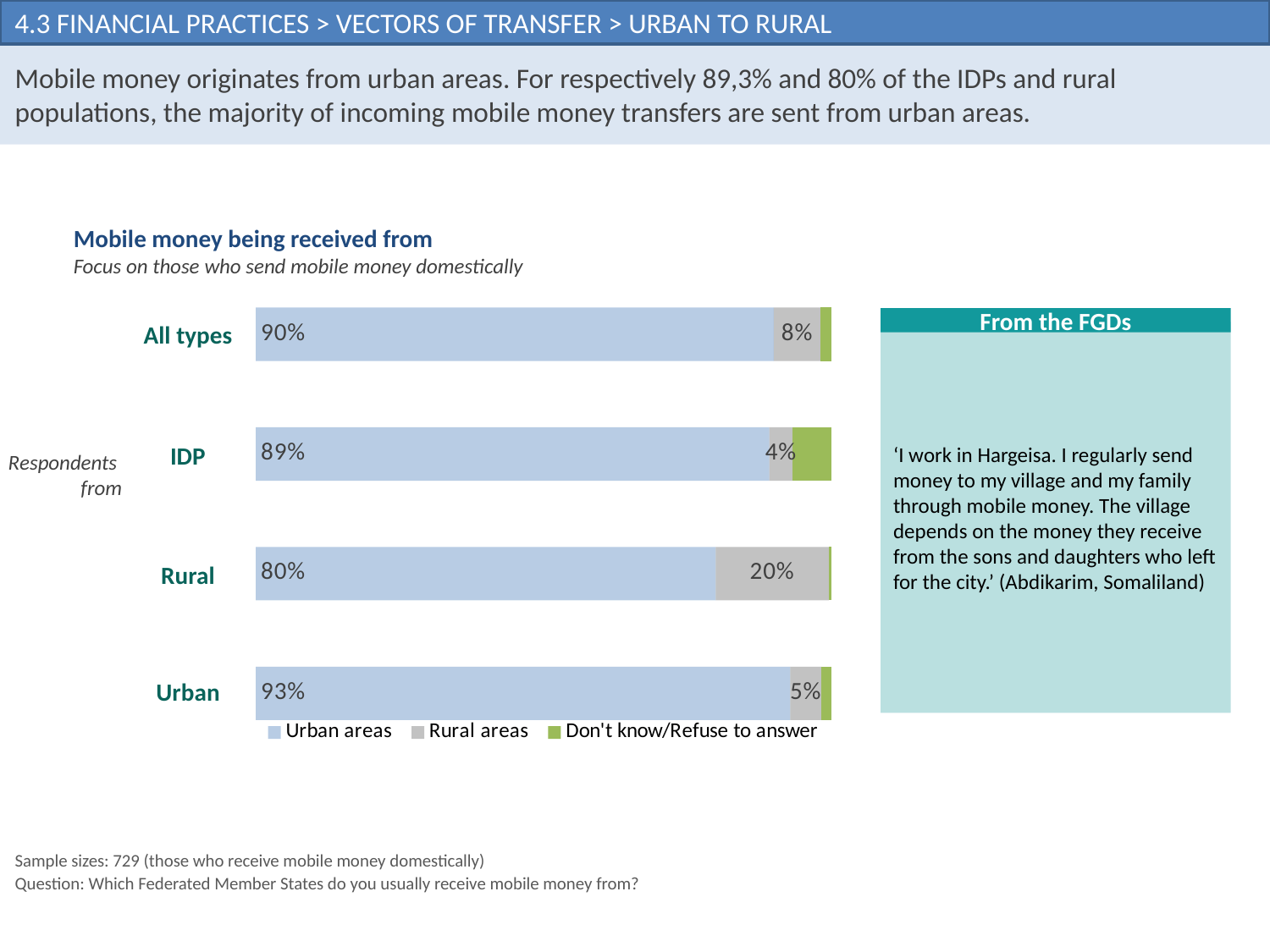
Which respondent group has the highest 'Urban areas' share? Urban What is the 'Urban areas' value for the IDP category? 89% What is the 'Rural areas' value for the All types category? 8% Is the 'Rural areas' value larger for Rural respondents or for IDP respondents? Rural What is the difference between the 'Urban areas' values for Urban and Rural respondents? 13 percentage points What type of chart is shown on the slide? Stacked bar chart Which respondent group has the lowest 'Urban areas' share? Rural Which respondent group has the highest 'Rural areas' share? Rural What is the 'Rural areas' value for Urban respondents? 5% How many series does the legend list? 3 What percentage of Rural respondents receive mobile money from urban areas? 80% How many respondent categories are shown in the chart? 4